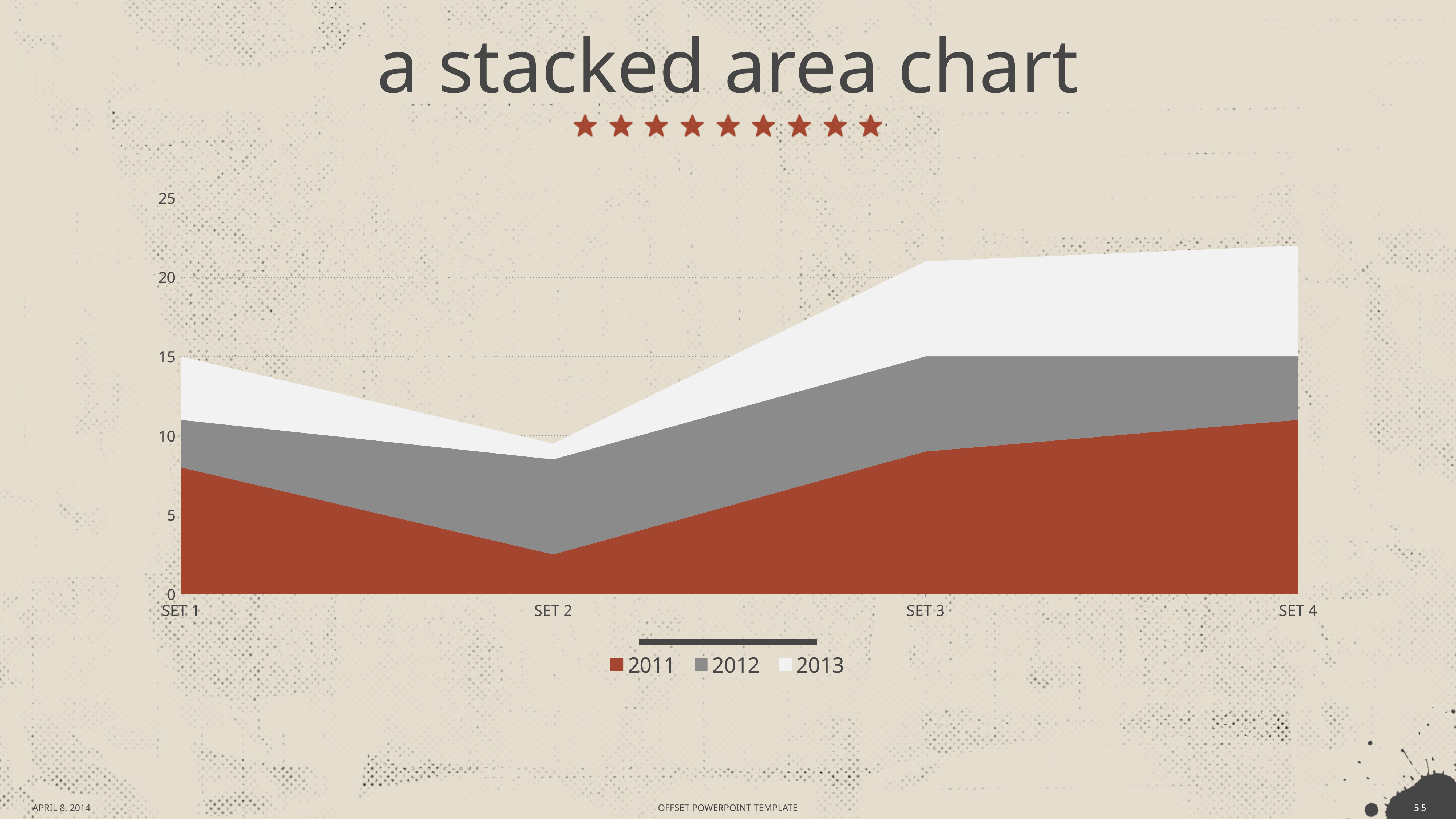
Is the value for 2011 at SET 4 greater or less than 10? greater How many categories are shown on the x axis? 4 How many series does the legend list? 3 Which series is shown in red? 2011 What is the title of the chart? a stacked area chart Is the stacked total at SET 3 greater or less than 20? greater At which category is the stacked total lowest? SET 2 Does the 2011 series rise or fall from SET 2 to SET 4? rise Is the value for 2011 at SET 1 greater or less than 5? greater What kind of chart is shown on the slide? stacked area chart At which category is the 2011 series lowest? SET 2